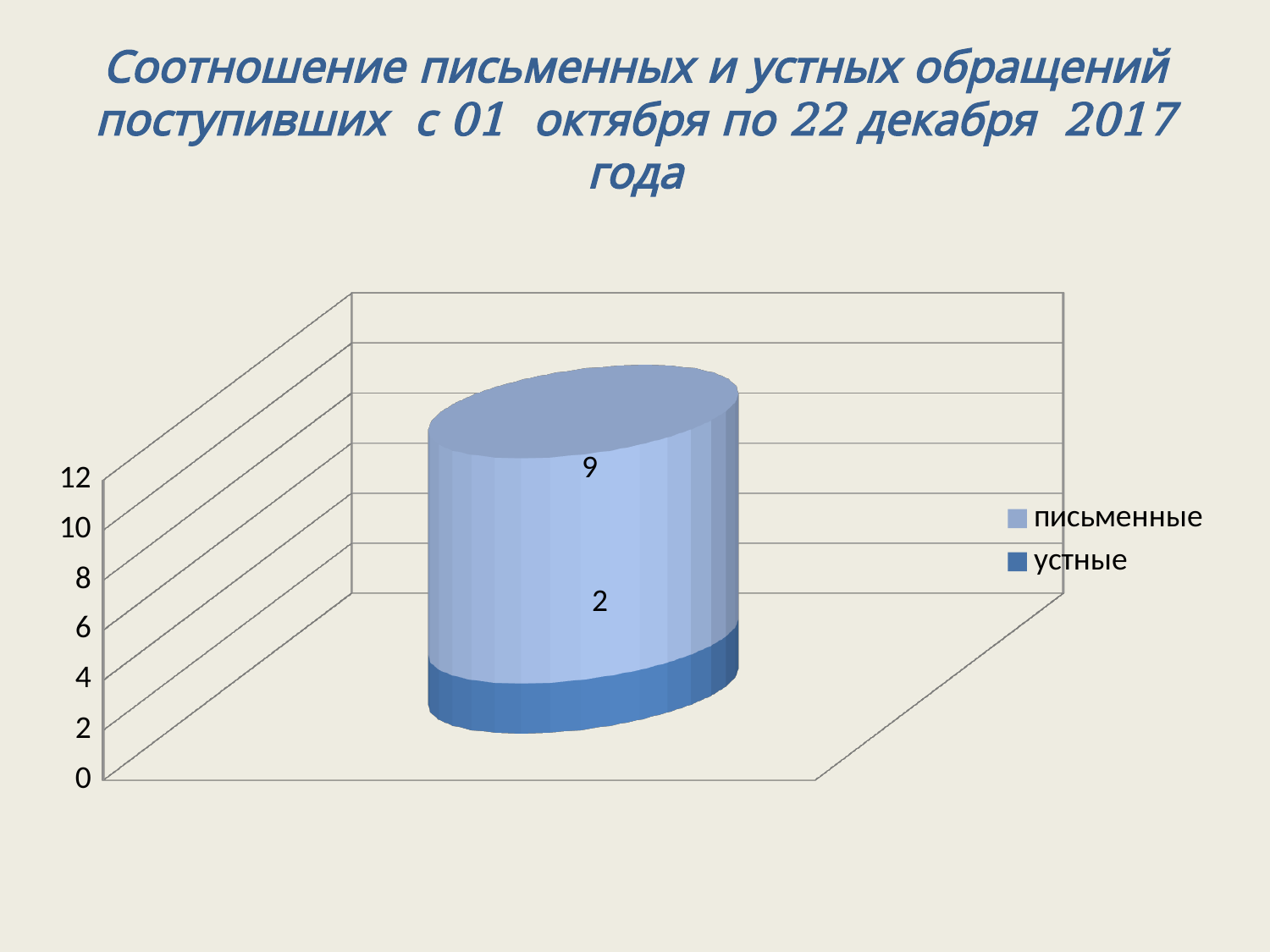
What is the maximum value shown on the vertical axis? 12 Which legend entry is shown in the darker blue colour? устные What kind of chart is shown on the slide? stacked bar chart How many series does the legend list? 2 What is the value for the series "письменные"? 9 Which series has the smallest value? устные What is the total of the stacked bar? 11 What is the difference between the values for "письменные" and "устные"? 7 Which series has the largest value? письменные What is the value for the series "устные"? 2 Which series has the larger value, "письменные" or "устные"? письменные How many bars are plotted in the chart? 1